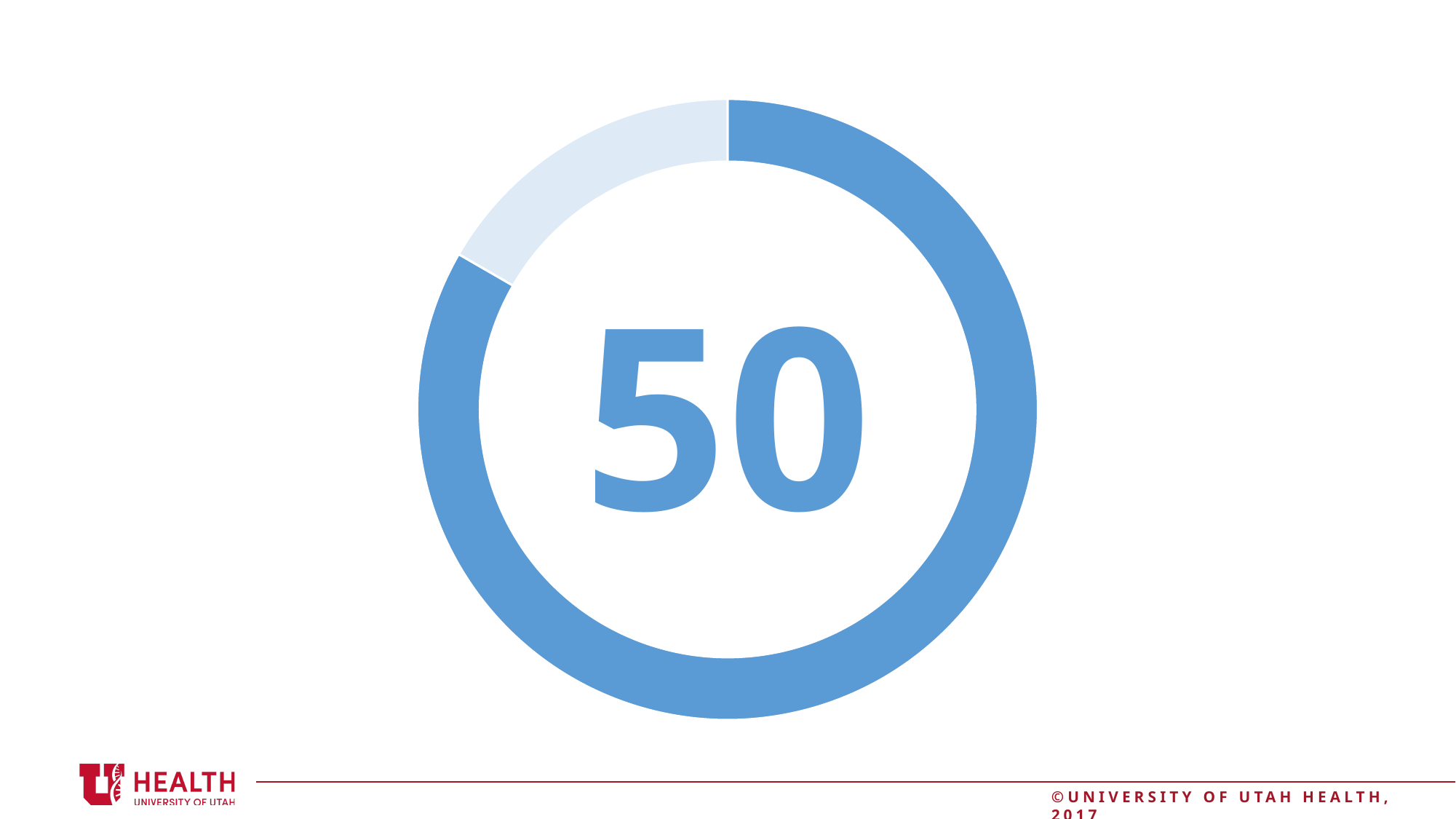
Does the dark blue segment of the doughnut chart cover more or less than half of the ring? More than half What colour is the smaller segment of the doughnut chart? Light blue What kind of chart is shown on the slide? Doughnut chart How many segments does the doughnut chart have? 2 What number is printed in the centre of the doughnut chart? 50 Which segment of the doughnut chart is larger, the dark blue one or the light blue one? The dark blue one